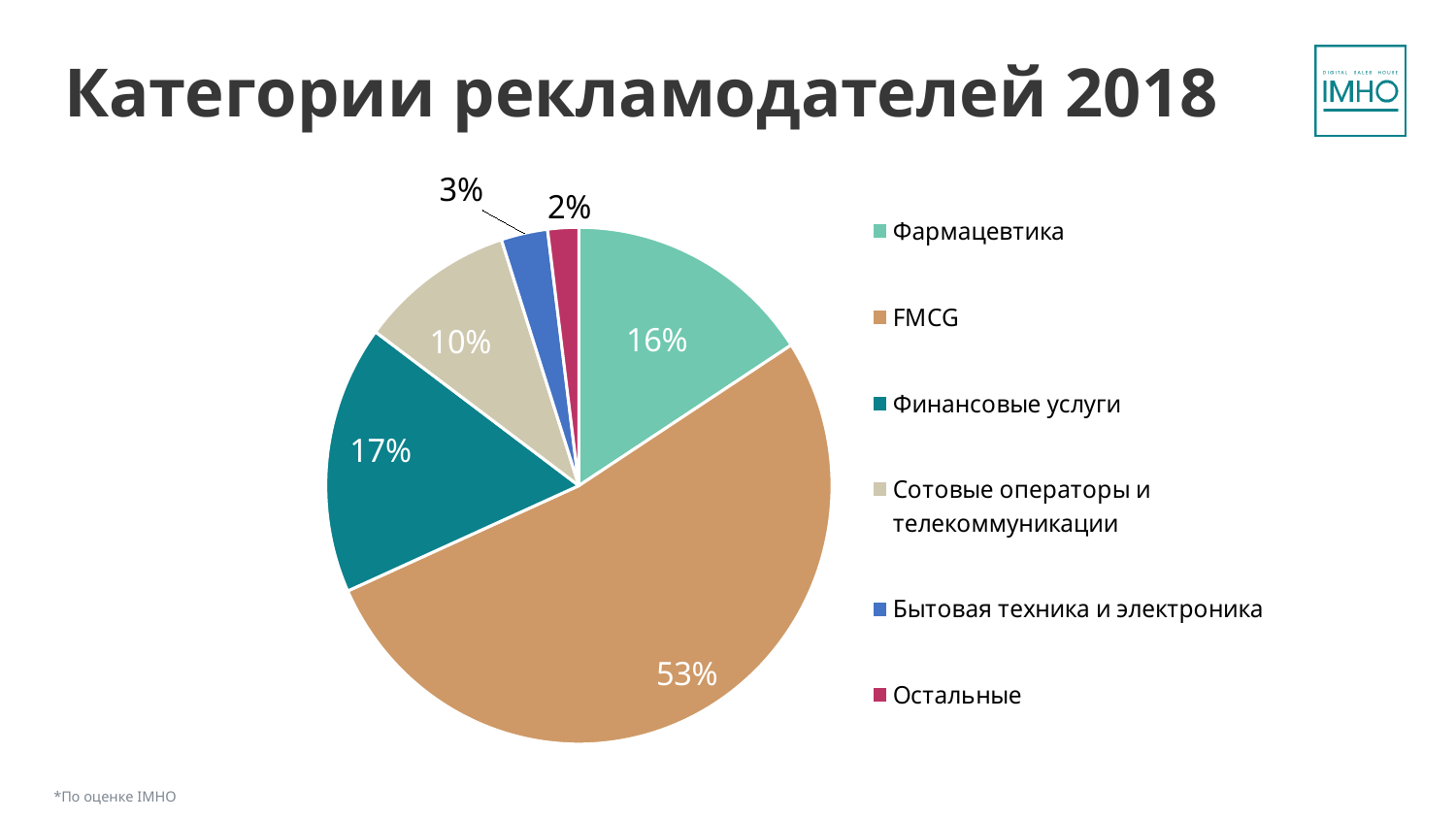
What share of the pie does FMCG have? 53% What kind of chart is shown on the slide? pie chart Which category has the smallest slice of the pie? Остальные Which category has the largest slice of the pie? FMCG What is the value for Сотовые операторы и телекоммуникации? 10% Which is larger, the share of Фармацевтика or the share of Сотовые операторы и телекоммуникации? Фармацевтика What is the value for Фармацевтика? 16% What is the value for Финансовые услуги? 17% How many categories does the legend list? 6 What is the value for Бытовая техника и электроника? 3% What is the title of the chart slide? Категории рекламодателей 2018 What is the difference between the shares of FMCG and Финансовые услуги? 36%